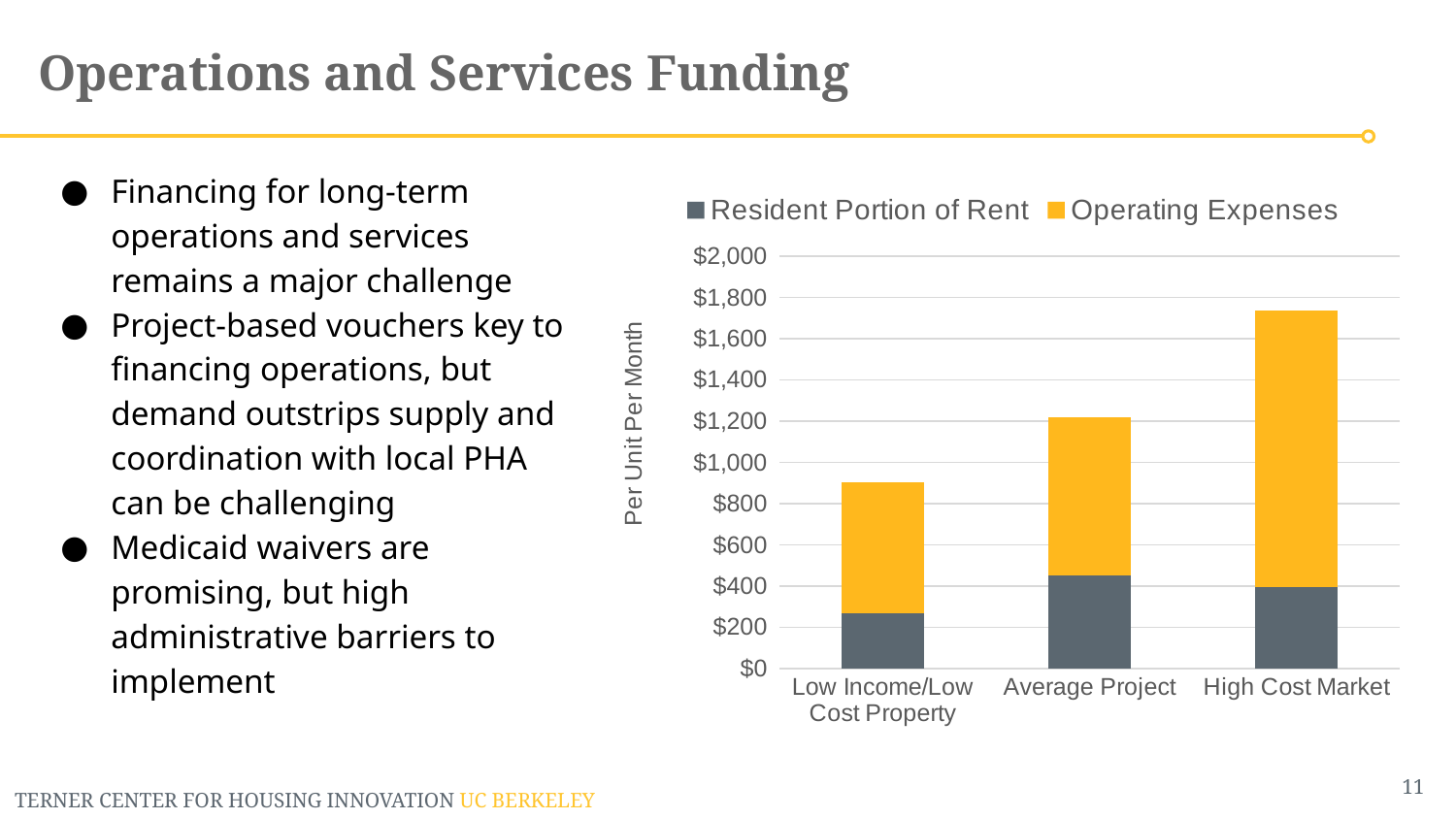
How many categories are shown on the x axis of the chart? 3 Is the Resident Portion of Rent for Low Income/Low Cost Property greater or less than $400? less Do the total bar heights rise or fall from left to right across the categories? Rise Which has a larger Resident Portion of Rent: Average Project or Low Income/Low Cost Property? Average Project What kind of chart is shown on the slide? Stacked bar chart Which category has the tallest stacked bar in the chart? High Cost Market Is the Resident Portion of Rent for High Cost Market greater or less than $600? less How many series does the chart's legend list? 2 Is the total bar height for Average Project greater or less than $1,000? greater Which category has the shortest stacked bar in the chart? Low Income/Low Cost Property